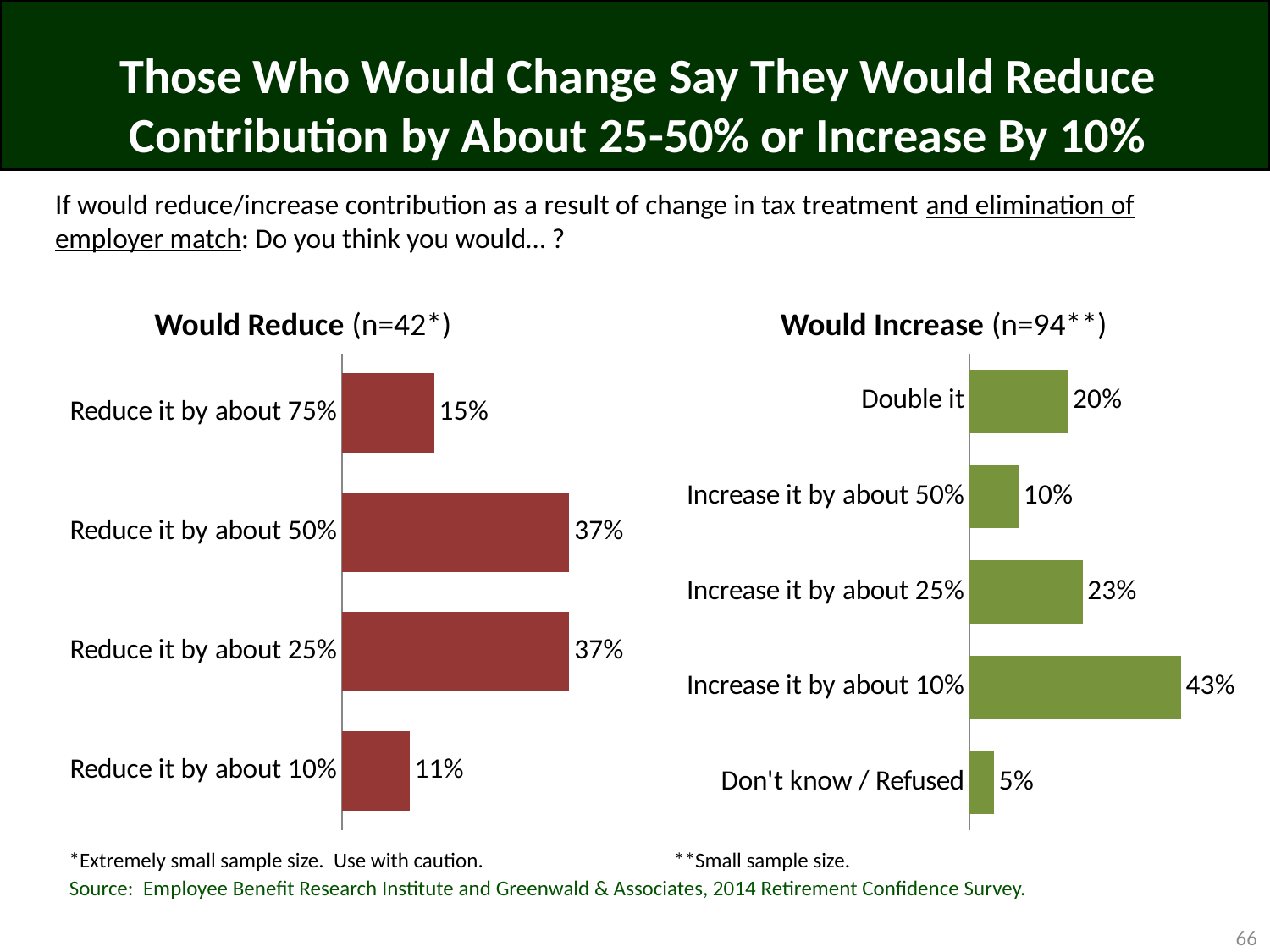
In the Would Reduce chart, what is the value for Reduce it by about 75%? 15% In the Would Reduce chart, what is the difference between Reduce it by about 50% and Reduce it by about 75%? 22% In the Would Increase chart, which category has the lowest value? Don't know / Refused In the Would Increase chart, which is larger: Double it or Increase it by about 25%? Increase it by about 25% How many categories does the Would Increase chart show? 5 In the Would Increase chart, what is the value for Increase it by about 10%? 43% In the Would Increase chart, what is the difference between Increase it by about 25% and Increase it by about 50%? 13% In the Would Reduce chart, what is the value for Reduce it by about 10%? 11% In the Would Increase chart, what is the value for Double it? 20% In the Would Reduce chart, which category has the lowest value? Reduce it by about 10% In the Would Increase chart, which category has the highest value? Increase it by about 10% What kind of chart is the Would Reduce chart? Bar chart